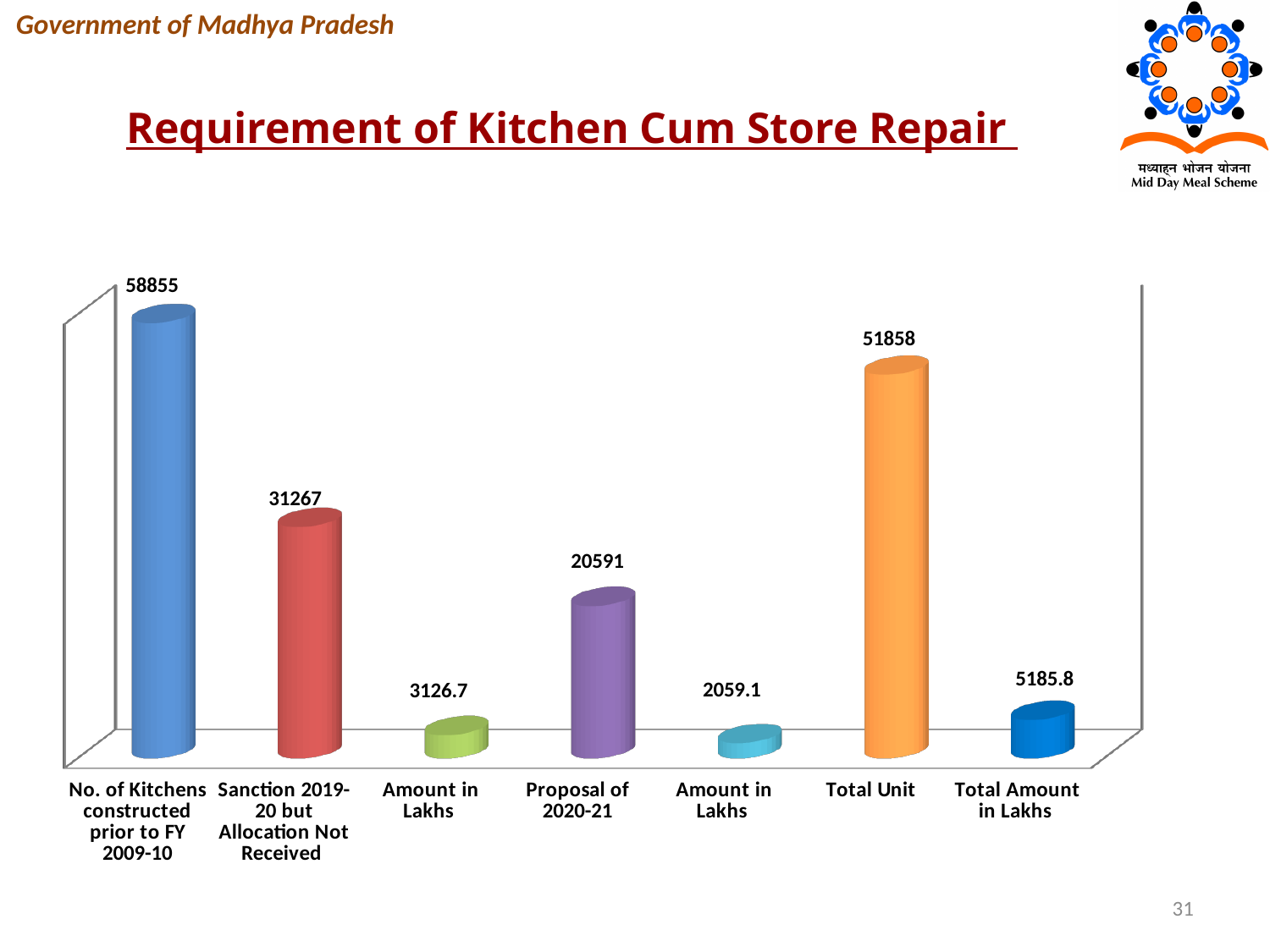
What is the value for 'Proposal of 2020-21'? 20591 What is the value for 'No. of Kitchens constructed prior to FY 2009-10'? 58855 What kind of chart is shown on the slide? Bar chart What is the difference between 'Total Unit' and 'Proposal of 2020-21'? 31267 Which is larger, 'Sanction 2019-20 but Allocation Not Received' or 'Proposal of 2020-21'? Sanction 2019-20 but Allocation Not Received How many bars are shown in the chart? 7 What is the value for 'Sanction 2019-20 but Allocation Not Received'? 31267 What is the value for 'Total Amount in Lakhs'? 5185.8 Which category has the highest value? No. of Kitchens constructed prior to FY 2009-10 What is the value of the fifth bar from the left, labelled 'Amount in Lakhs' next to 'Proposal of 2020-21'? 2059.1 Which bar has the lowest value? The fifth bar, 'Amount in Lakhs' (2059.1) What is the value for 'Total Unit'? 51858